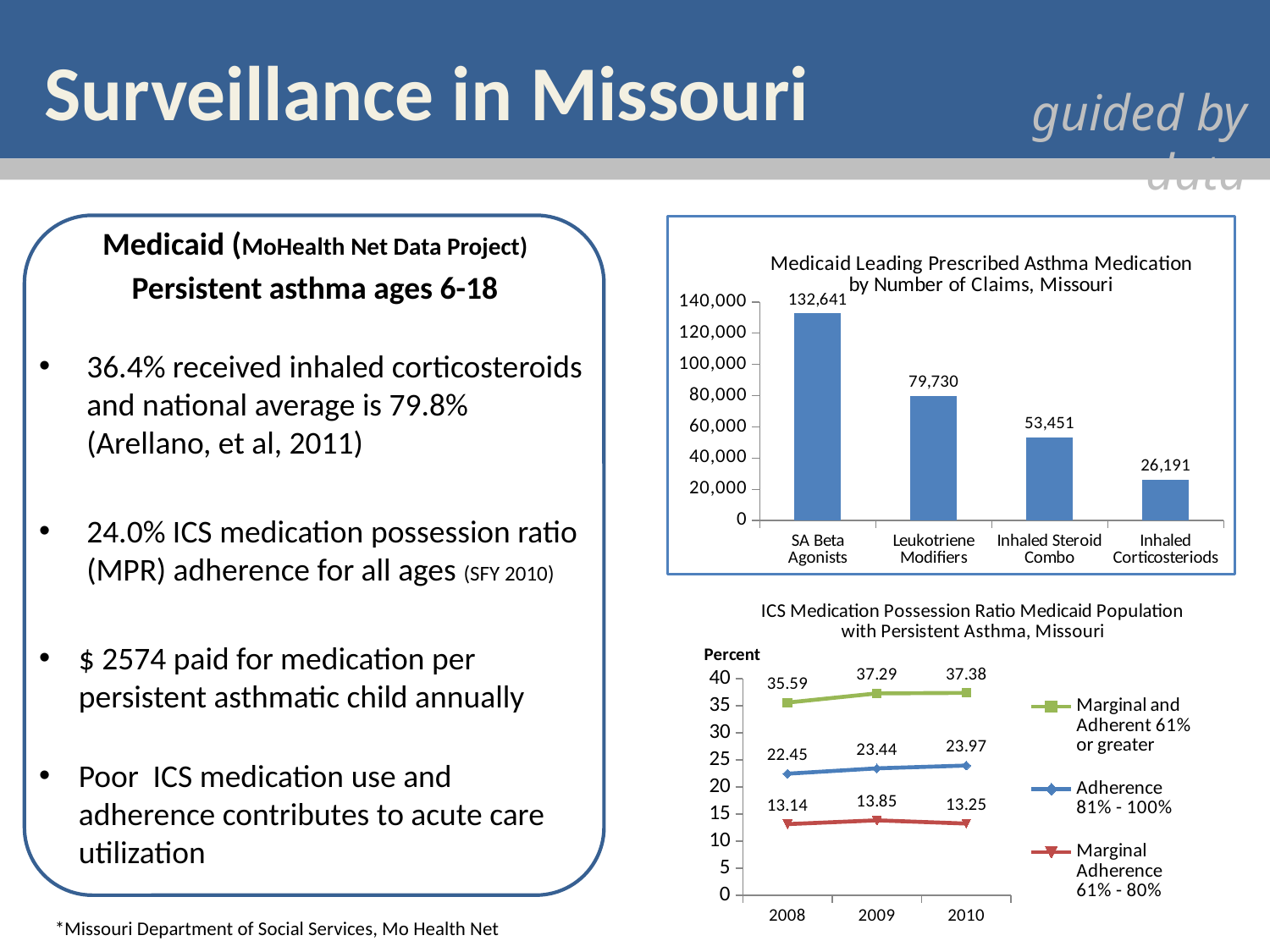
What type of chart is 'Medicaid Leading Prescribed Asthma Medication by Number of Claims, Missouri'? Bar chart In the chart 'Medicaid Leading Prescribed Asthma Medication by Number of Claims, Missouri', how many claims are shown for SA Beta Agonists? 132,641 In the chart 'Medicaid Leading Prescribed Asthma Medication by Number of Claims, Missouri', do the values rise or fall from left to right? Fall In the chart 'ICS Medication Possession Ratio Medicaid Population with Persistent Asthma, Missouri', which series has the highest value in 2008? Marginal and Adherent 61% or greater In the chart 'Medicaid Leading Prescribed Asthma Medication by Number of Claims, Missouri', how many medication categories are shown? 4 In the chart 'ICS Medication Possession Ratio Medicaid Population with Persistent Asthma, Missouri', what is the value for Marginal Adherence 61% - 80% in 2009? 13.85 In the chart 'ICS Medication Possession Ratio Medicaid Population with Persistent Asthma, Missouri', what is the value for Adherence 81% - 100% in 2010? 23.97 In the chart 'Medicaid Leading Prescribed Asthma Medication by Number of Claims, Missouri', which medication has the fewest claims? Inhaled Corticosteriods In the chart 'ICS Medication Possession Ratio Medicaid Population with Persistent Asthma, Missouri', how many series does the legend list? 3 In the chart 'ICS Medication Possession Ratio Medicaid Population with Persistent Asthma, Missouri', what is the label on the vertical axis? Percent In the chart 'ICS Medication Possession Ratio Medicaid Population with Persistent Asthma, Missouri', what is the difference between the Marginal and Adherent 61% or greater values in 2010 and 2008? 1.79 In the chart 'Medicaid Leading Prescribed Asthma Medication by Number of Claims, Missouri', what is the difference in claims between Leukotriene Modifiers and Inhaled Steroid Combo? 26,279